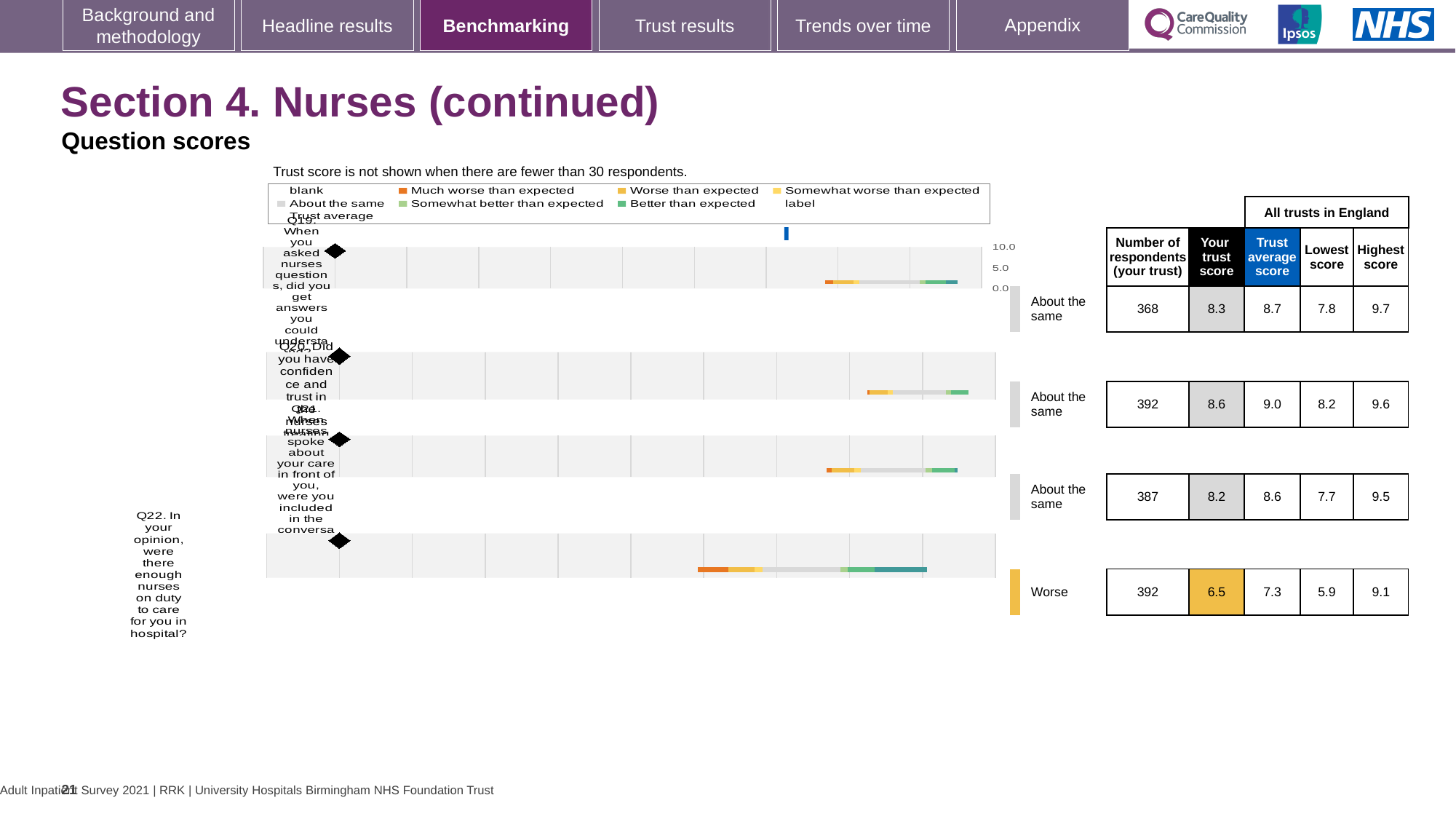
How many respondents from the trust answered Q19? 368 Which question has the highest 'Your trust score'? Q20 What kind of chart is used to show the question scores? bar chart What is the lowest score across all trusts in England for Q22? 5.9 What is the trust's score for Q22 (were there enough nurses on duty to care for you in hospital)? 6.5 What is the highest score across all trusts in England for Q19? 9.7 For Q22, how much lower is the trust's score than the trust average score? 0.8 What is the trust average score for Q20 (confidence and trust in nurses)? 9.0 For Q19, is the trust's score higher or lower than the trust average score? lower Which question has the lowest 'Your trust score'? Q22 Which question is rated 'Worse' rather than 'About the same'? Q22 How many questions are shown on the chart? 4